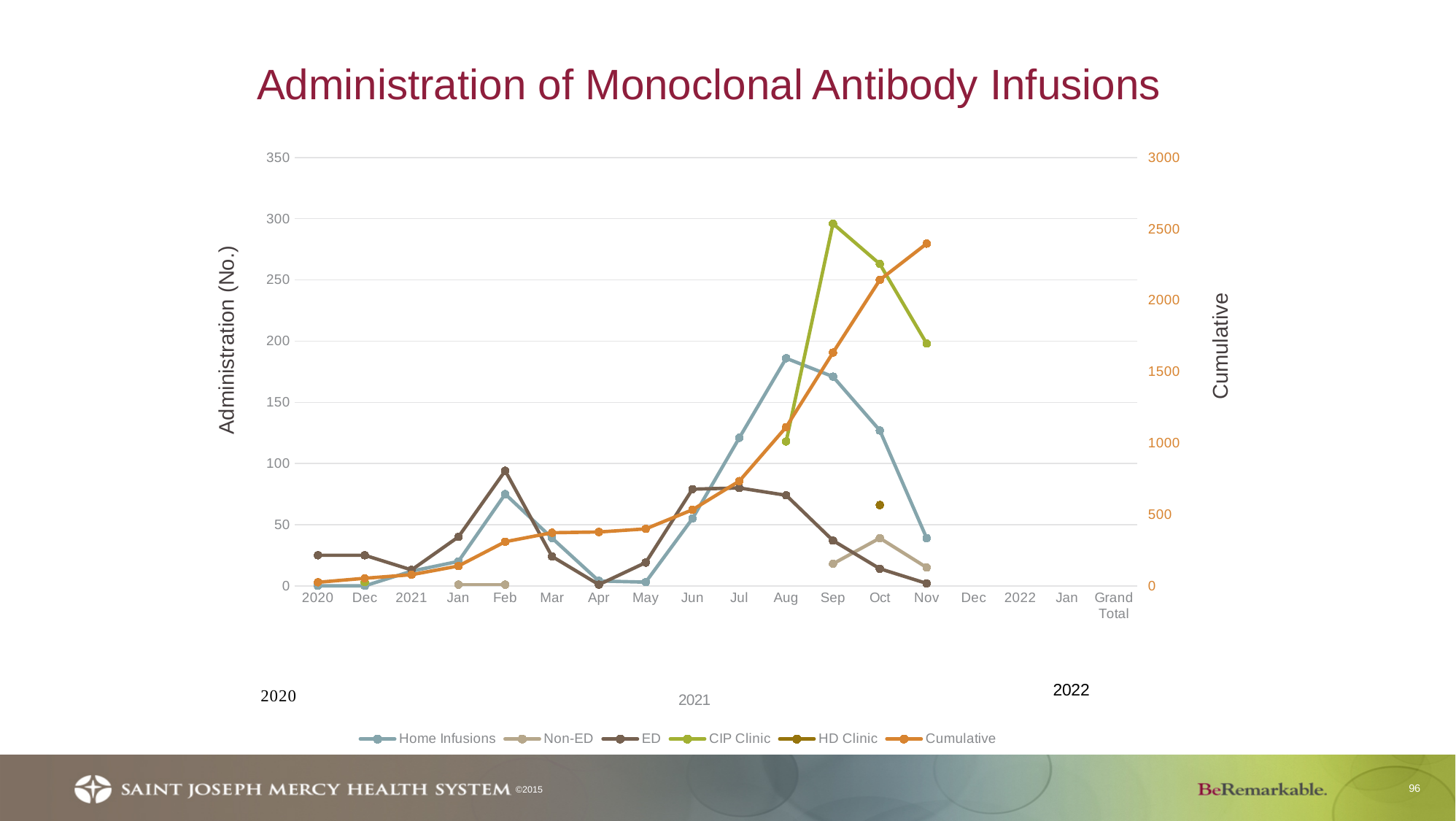
Is the value for Home Infusions in Nov greater or less than 50? less What kind of chart is shown on the slide? line chart What is the title of the chart? Administration of Monoclonal Antibody Infusions Does the Cumulative series rise or fall from 2020 to Nov 2021? rise In which month does the CIP Clinic series reach its highest value? Sep In which month does the ED series reach its highest value? Feb Is the Cumulative value in Nov greater or less than 2000 on the right-hand axis? greater In Aug, which is larger: Home Infusions or ED? Home Infusions Is the value for CIP Clinic in Sep greater or less than 250? greater What is the label of the right-hand vertical axis? Cumulative How many series does the legend list? 6 In which month does the Home Infusions series reach its highest value? Aug